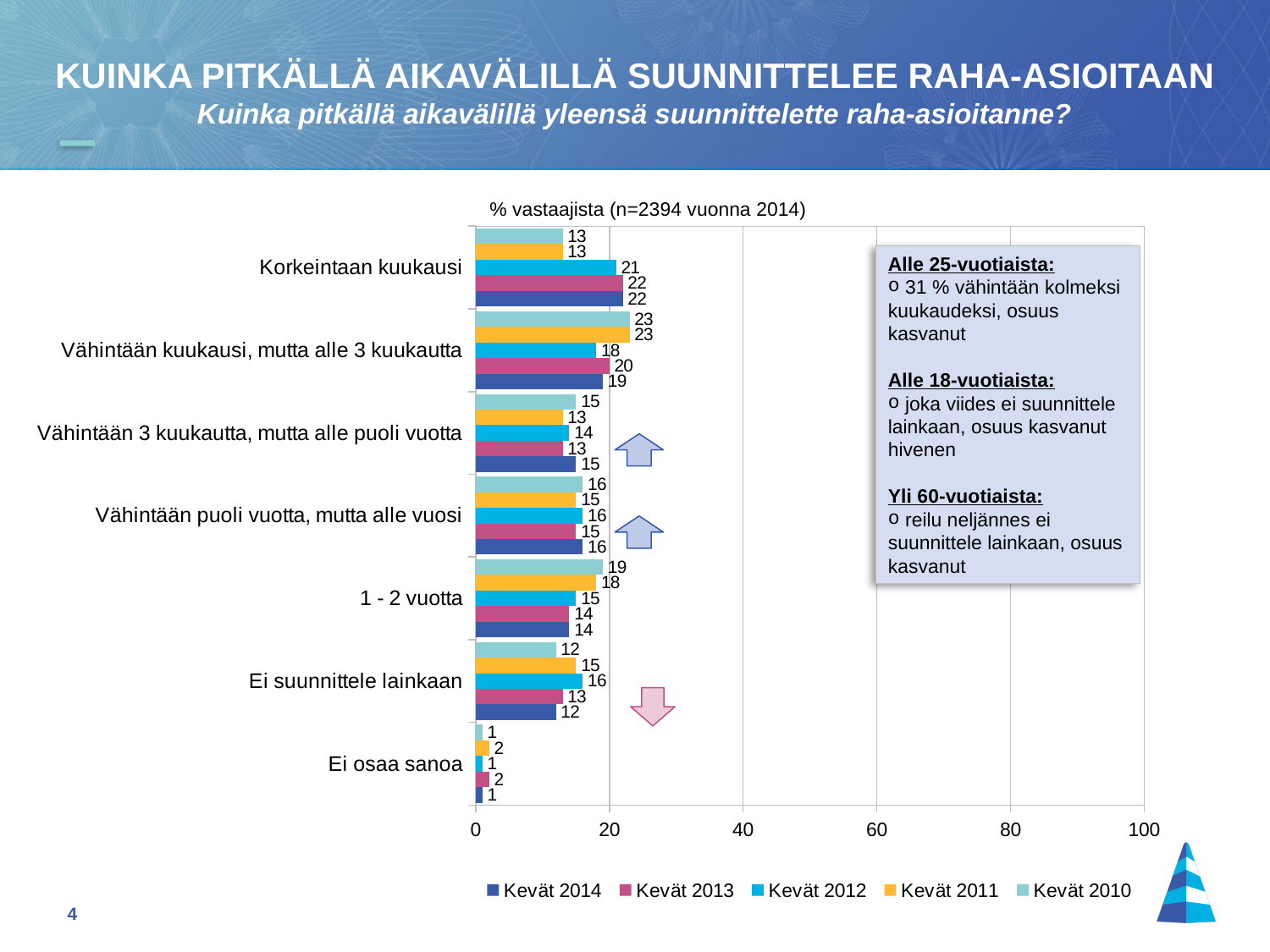
How many categories are shown on the chart? 7 What is the value for Kevät 2012 in the category "Ei suunnittele lainkaan"? 16 What is the value for Kevät 2014 in the category "Korkeintaan kuukausi"? 22 How many series does the legend list? 5 Which category has the lowest value for Kevät 2014? Ei osaa sanoa What type of chart is shown on the slide? Bar chart What is the value for Kevät 2011 in the category "Vähintään kuukausi, mutta alle 3 kuukautta"? 23 Which category has the highest value for Kevät 2014? Korkeintaan kuukausi What is the difference between the Kevät 2014 and Kevät 2010 values for "Korkeintaan kuukausi"? 9 What is the value for Kevät 2010 in the category "1 - 2 vuotta"? 19 What is the axis label shown above the chart? % vastaajista (n=2394 vuonna 2014) Which is larger for "1 - 2 vuotta": the Kevät 2010 value or the Kevät 2014 value? Kevät 2010